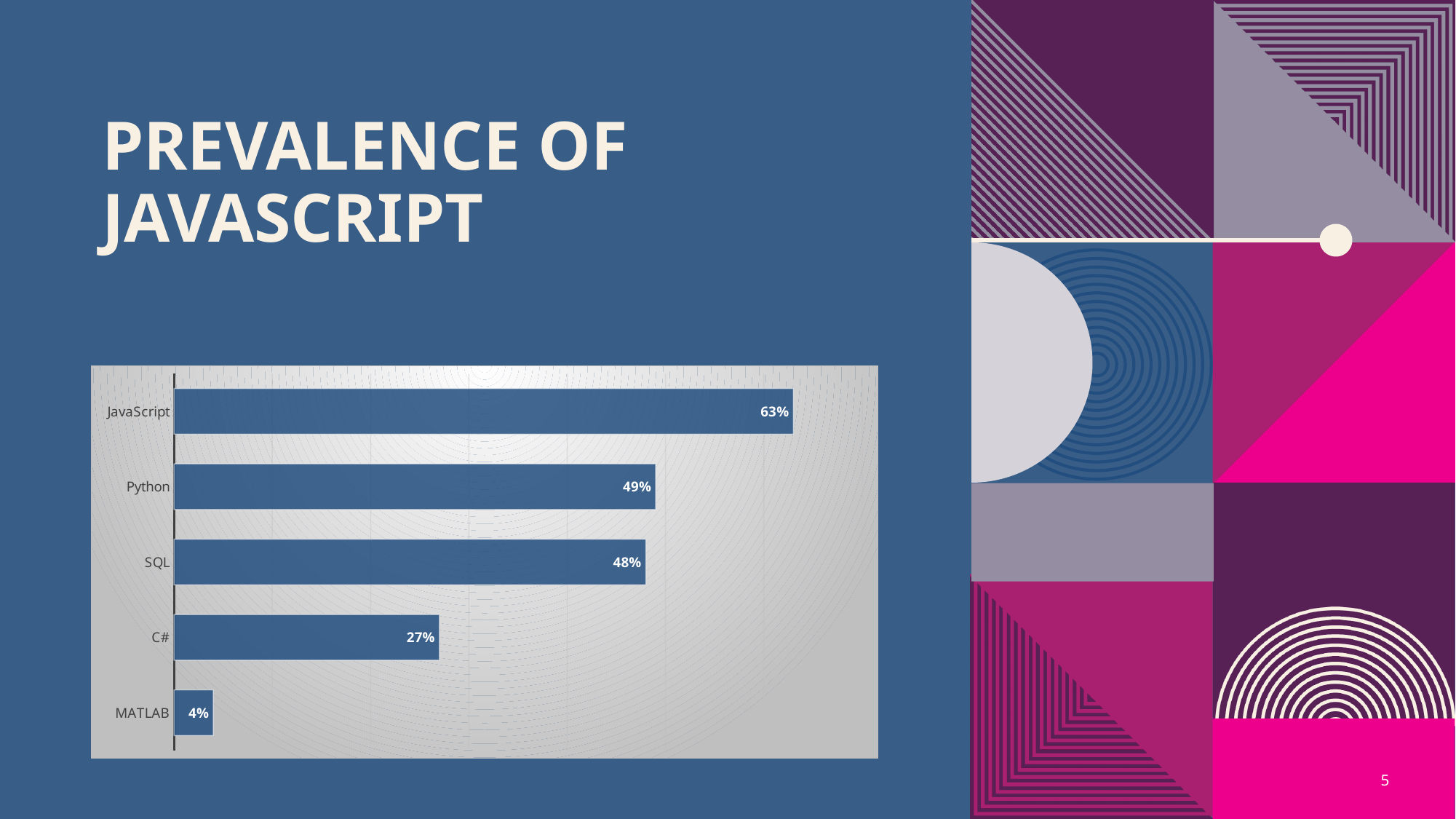
What is the value for Python? 49% What is the value for C#? 27% What is the difference between the values for JavaScript and Python? 14% How many categories are shown in the chart? 5 Which category has the highest value? JavaScript Which category has the lowest value? MATLAB What is the value for JavaScript? 63% What is the difference between the values for SQL and C#? 21% Which is larger, the value for Python or the value for C#? Python What kind of chart is shown on the slide? Bar chart What is the title of the slide containing the chart? Prevalence of JavaScript What is the value for MATLAB? 4%